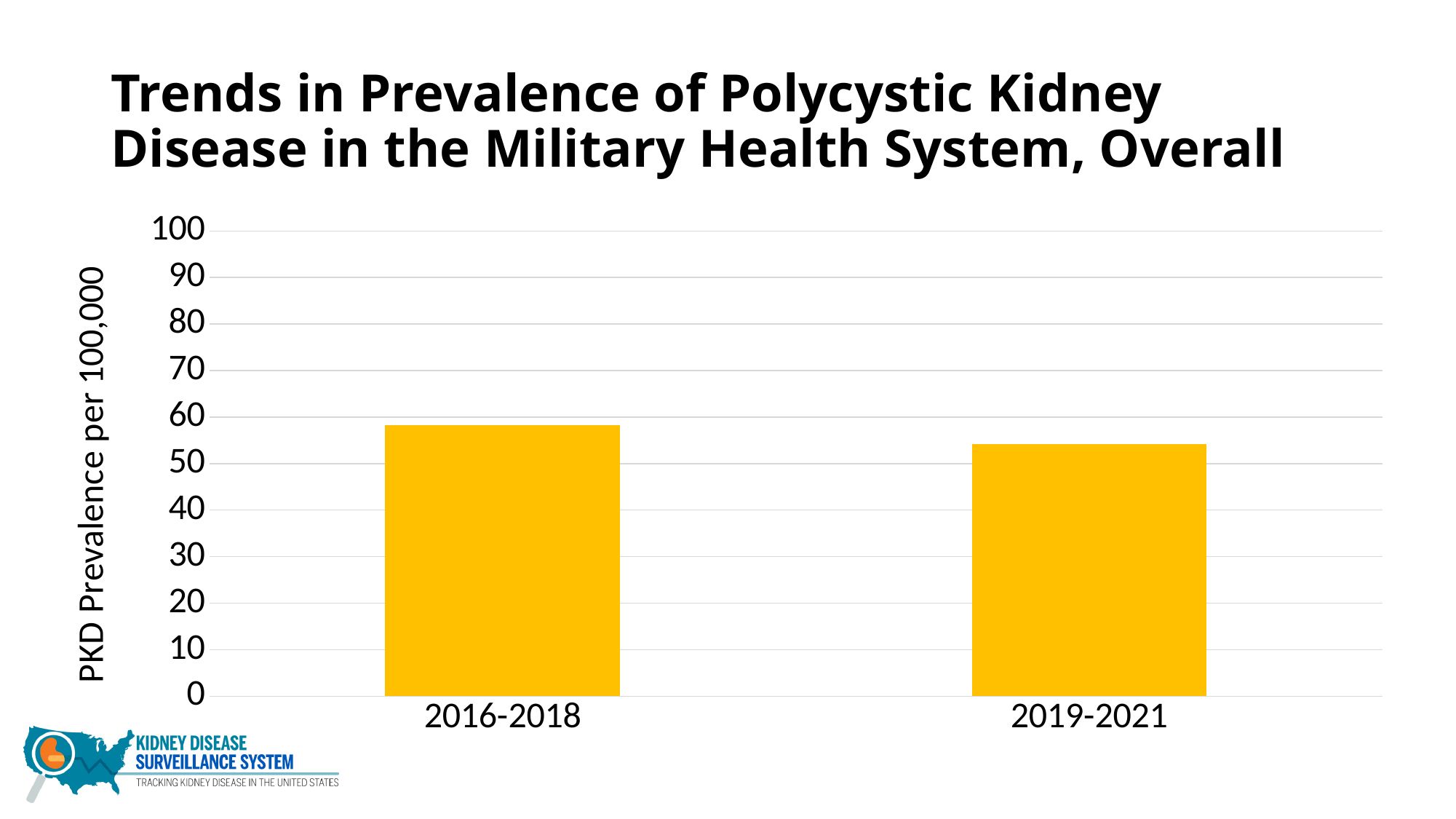
Is the value for 2016-2018 larger or smaller than the value for 2019-2021? larger Is the value for 2016-2018 greater or less than 60? less Which period has the higher PKD prevalence per 100,000? 2016-2018 Does PKD prevalence rise or fall from 2016-2018 to 2019-2021? fall How many bars (categories) are plotted in the chart? 2 Is the value for 2019-2021 greater or less than 60? less What is the label of the y axis? PKD Prevalence per 100,000 What is the title of the chart? Trends in Prevalence of Polycystic Kidney Disease in the Military Health System, Overall What kind of chart is shown on the slide? bar chart Is the value for 2019-2021 greater or less than 50? greater Which period has the lower PKD prevalence per 100,000? 2019-2021